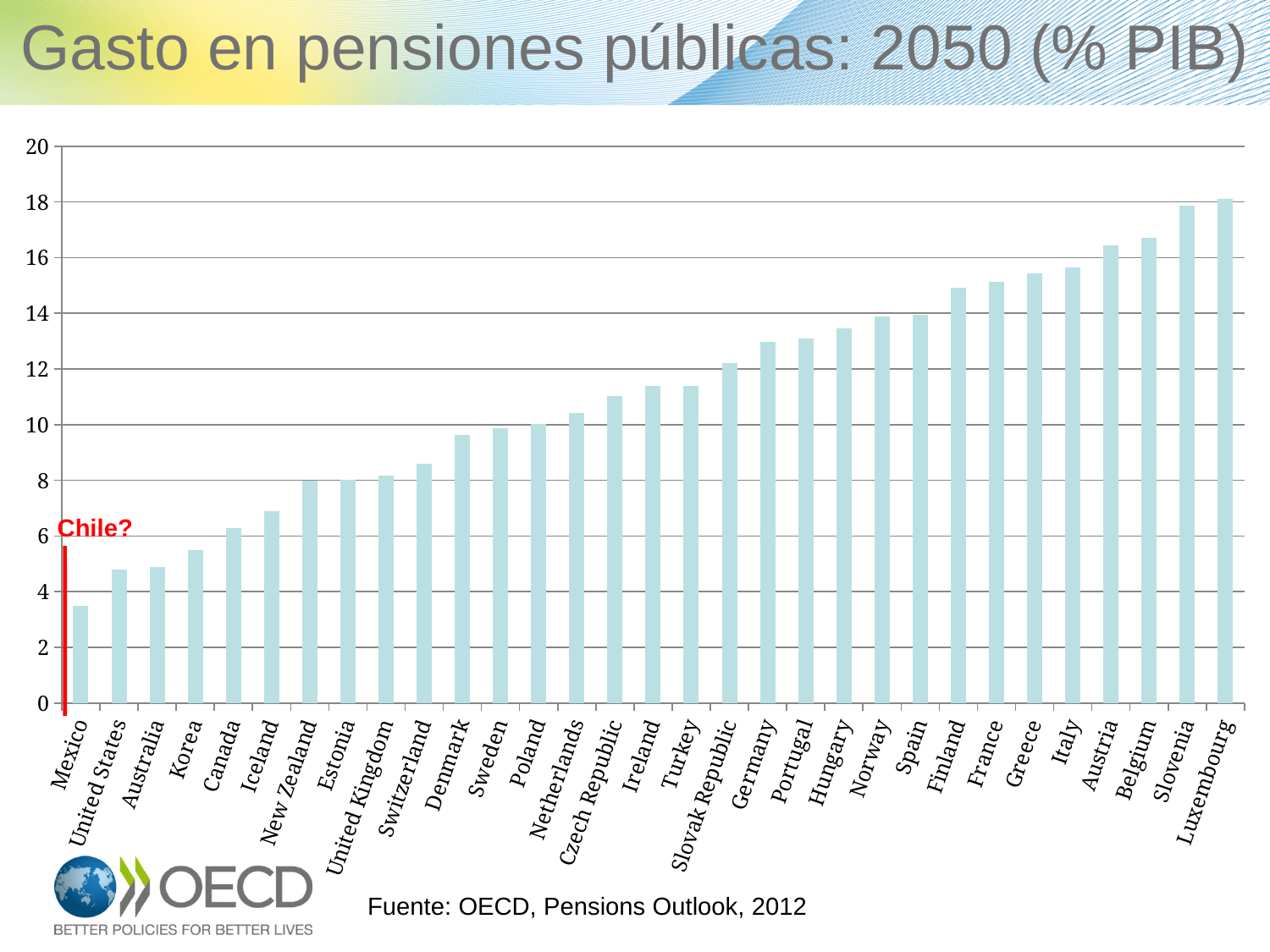
What is the title of the chart on the slide? Gasto en pensiones públicas: 2050 (% PIB) How many countries are shown on the x axis of the chart? 31 Is the value for Mexico greater or less than 4? less Is the value for Denmark greater or less than 10? less What kind of chart is shown on the slide? bar chart Which has the larger value, Spain or Canada? Spain Do the bar values rise or fall moving from left to right along the x axis? rise Which has the larger value, Germany or Korea? Germany Is the value for Luxembourg greater or less than 16? greater Which country has the lowest public pension spending in the chart? Mexico